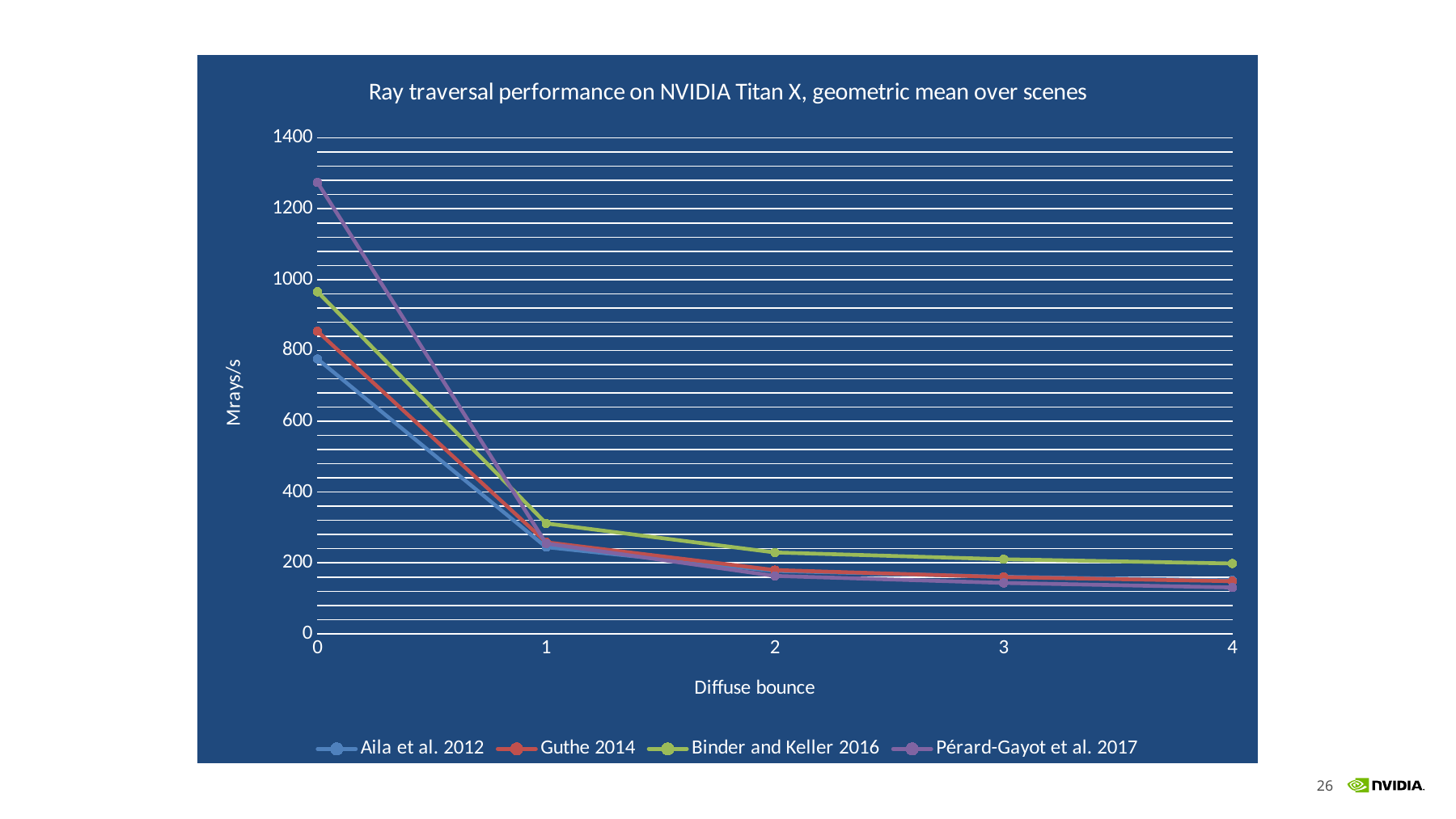
Which series has the highest value at diffuse bounce 0? Pérard-Gayot et al. 2017 At diffuse bounce 0, which is larger: Binder and Keller 2016 or Guthe 2014? Binder and Keller 2016 How many series does the legend list? 4 Which series has the lowest value at diffuse bounce 0? Aila et al. 2012 Is the value for Binder and Keller 2016 at diffuse bounce 0 greater or less than 1000? less What kind of chart is shown on the slide? line chart Which series has the highest value at diffuse bounce 4? Binder and Keller 2016 How many diffuse bounce values are plotted along the x axis? 5 Is the value for Aila et al. 2012 at diffuse bounce 4 greater or less than 200? less Do the values for Pérard-Gayot et al. 2017 rise or fall as the diffuse bounce increases? fall What is the label of the y axis? Mrays/s Is the value for Pérard-Gayot et al. 2017 at diffuse bounce 0 greater or less than 1200? greater